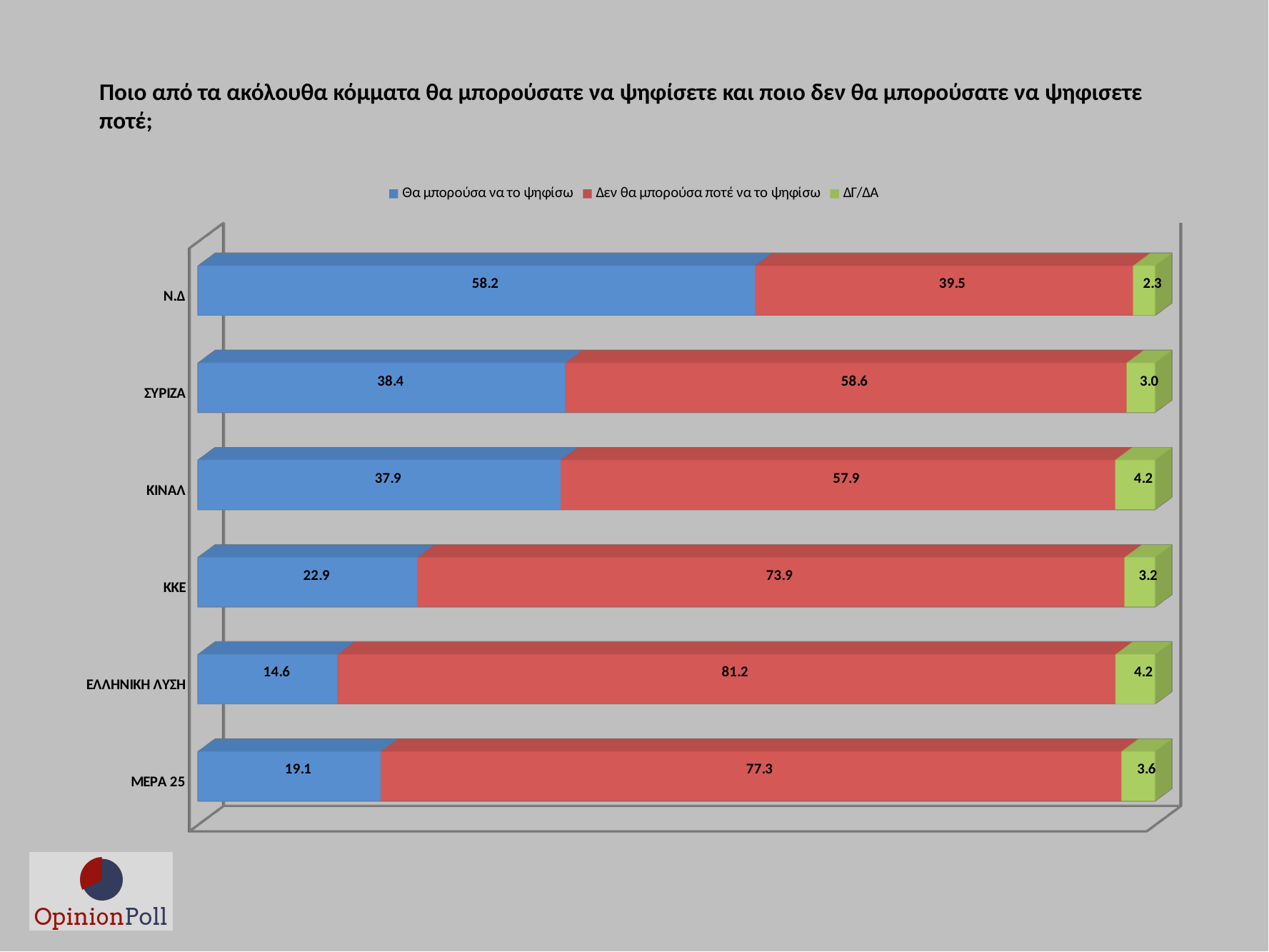
How many series does the legend list? 3 What is the value of "Δεν θα μπορούσα ποτέ να το ψηφίσω" for ΚΚΕ? 73.9 What is the total of the stacked bar for ΚΙΝΑΛ? 100.0 What kind of chart is shown on the slide? Stacked bar chart What is the difference between the "Δεν θα μπορούσα ποτέ να το ψηφίσω" values for ΜΕΡΑ 25 and ΚΚΕ? 3.4 Which party has the highest value for "Δεν θα μπορούσα ποτέ να το ψηφίσω"? ΕΛΛΗΝΙΚΗ ΛΥΣΗ Which is larger: the "Θα μπορούσα να το ψηφίσω" value for ΣΥΡΙΖΑ or for ΚΙΝΑΛ? ΣΥΡΙΖΑ What is the ΔΓ/ΔΑ value for ΣΥΡΙΖΑ? 3.0 Which party has the lowest value for "Θα μπορούσα να το ψηφίσω"? ΕΛΛΗΝΙΚΗ ΛΥΣΗ How many parties are shown on the chart? 6 Which colour represents the "ΔΓ/ΔΑ" series? Green What is the value of "Θα μπορούσα να το ψηφίσω" for Ν.Δ? 58.2